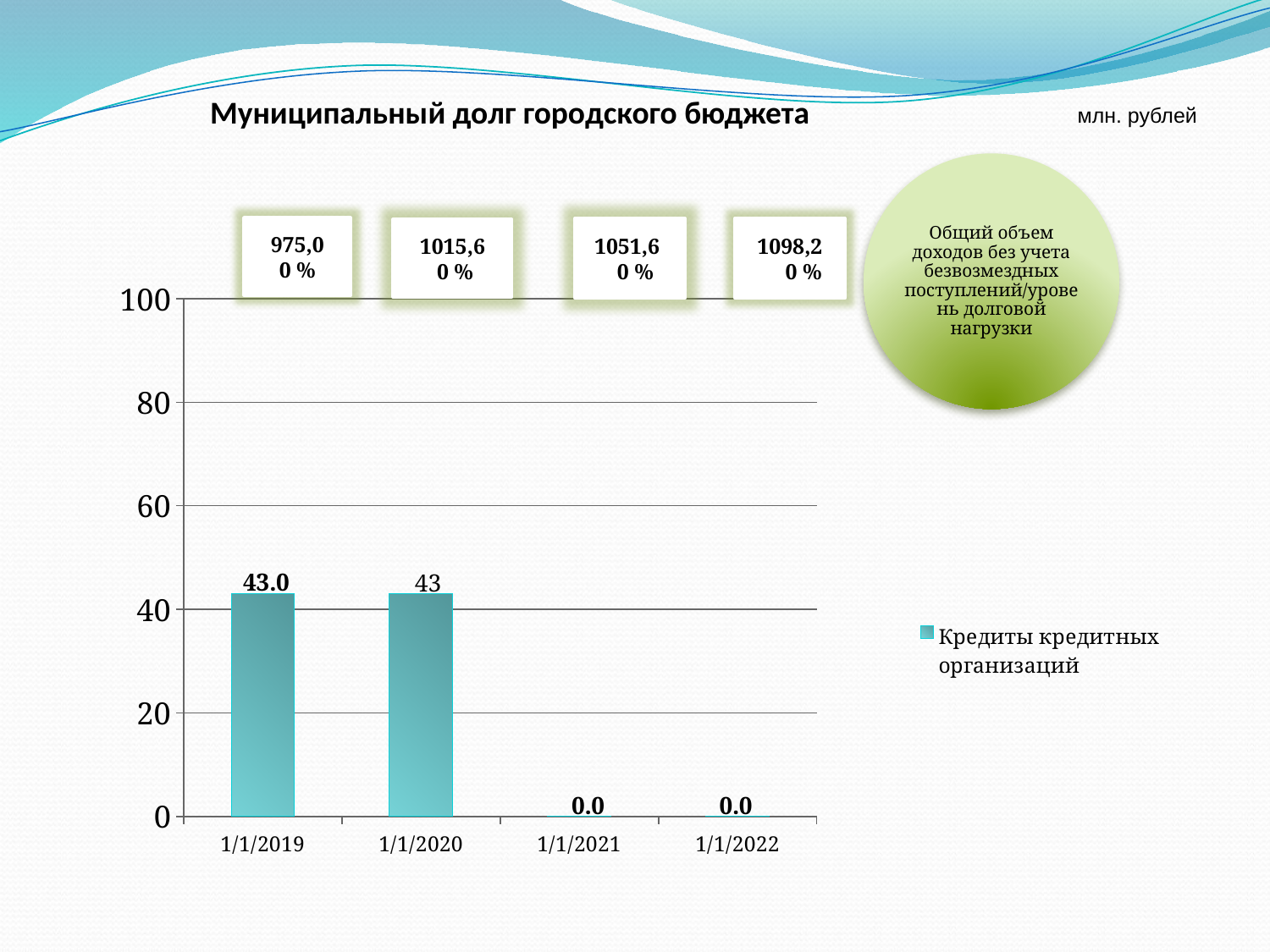
What is the difference between the values for 1/1/2020 and 1/1/2022? 43 How many series does the legend list? 1 Do the values rise or fall from 1/1/2020 to 1/1/2021? fall Is the value for 1/1/2019 greater or less than 60? less What is the value for 1/1/2021? 0.0 What series name is listed in the legend? Кредиты кредитных организаций How many categories are shown on the x axis? 4 Which category has the lowest value, 1/1/2020 or 1/1/2021? 1/1/2021 What is the value for 1/1/2019? 43.0 What kind of chart is shown? bar chart What is the value for 1/1/2020? 43 What is the value for 1/1/2022? 0.0